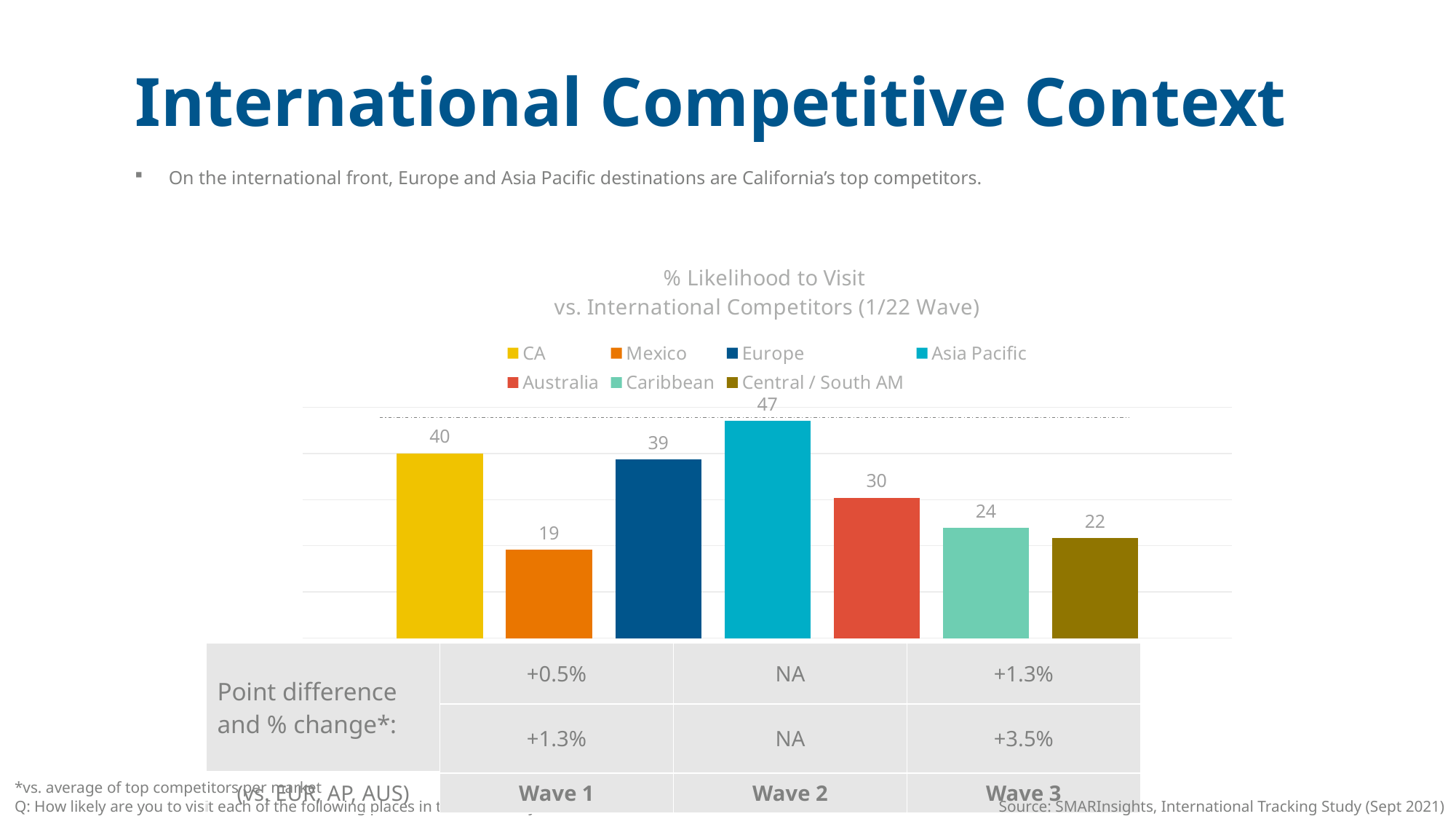
What is the % likelihood to visit value for CA? 40 What is the value shown for Caribbean? 24 Which destination has the lowest % likelihood to visit? Mexico What is the value shown for Mexico? 19 How many entries does the legend list? 7 Which destination has the highest % likelihood to visit? Asia Pacific What is the difference between the values for Australia and Central / South AM? 8 What is the value shown for Asia Pacific? 47 What type of chart is shown on the slide? Bar chart What is the difference between the values for Asia Pacific and CA? 7 Which has a higher value, Europe or Australia? Europe How many destinations are plotted in the chart? 7